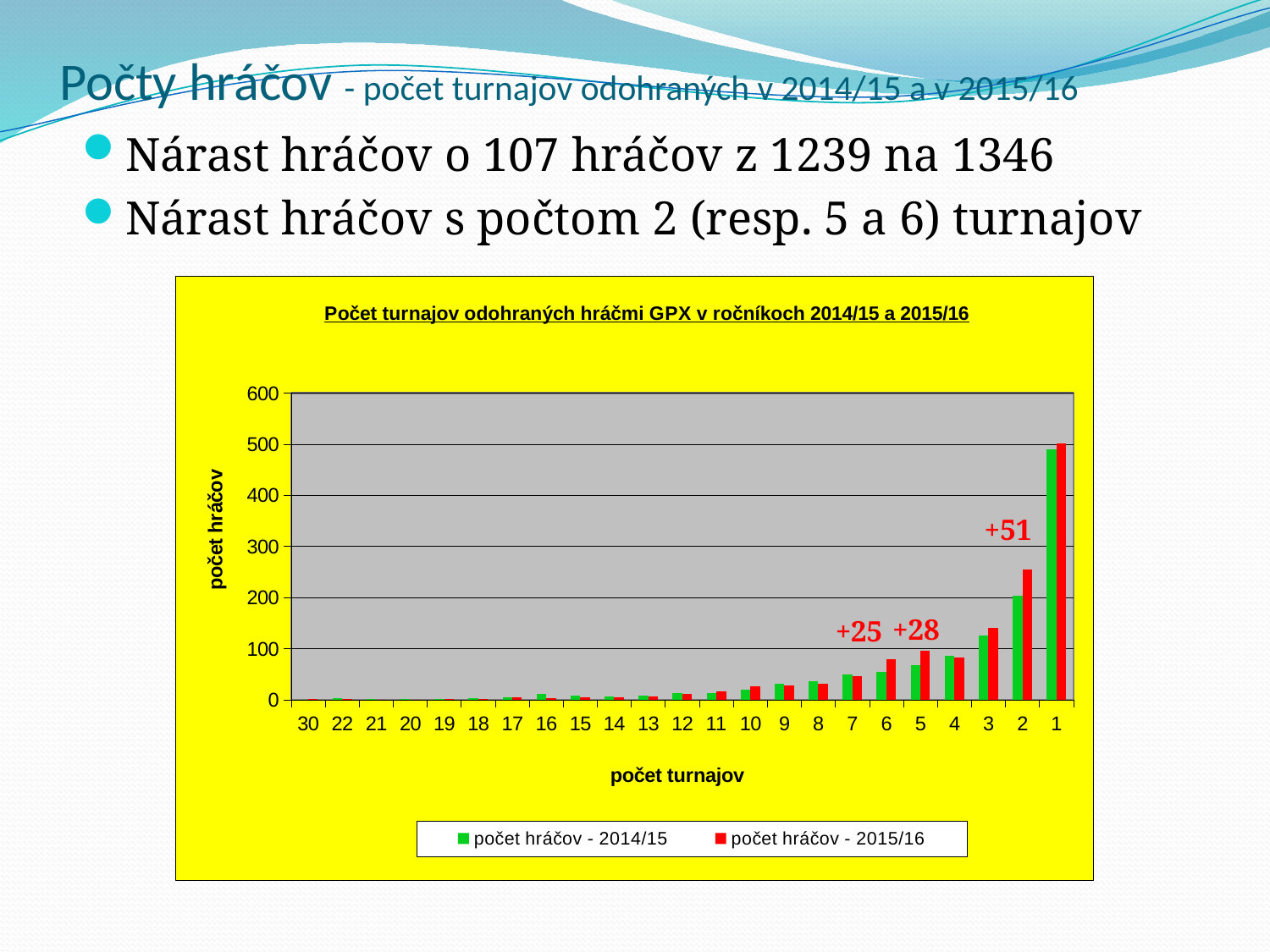
How many categories are shown on the x axis of the chart? 23 Which category on the x axis has the highest value for the series 'počet hráčov - 2015/16'? 1 Do the values generally rise or fall moving from left (30) to right (1) along the x axis? rise Is the value for category 2 in the series 'počet hráčov - 2015/16' greater or less than 200? greater For category 5, which series has the larger value: 'počet hráčov - 2014/15' or 'počet hráčov - 2015/16'? počet hráčov - 2015/16 Is the value for category 3 in the series 'počet hráčov - 2014/15' greater or less than 100? greater For category 2, which series has the larger value: 'počet hráčov - 2014/15' or 'počet hráčov - 2015/16'? počet hráčov - 2015/16 What kind of chart is shown on the slide? bar chart Which category on the x axis has the highest value for the series 'počet hráčov - 2014/15'? 1 How many series does the chart legend list? 2 Is the value for category 4 in the series 'počet hráčov - 2014/15' greater or less than 100? less What is the title of the chart? Počet turnajov odohraných hráčmi GPX v ročníkoch 2014/15 a 2015/16